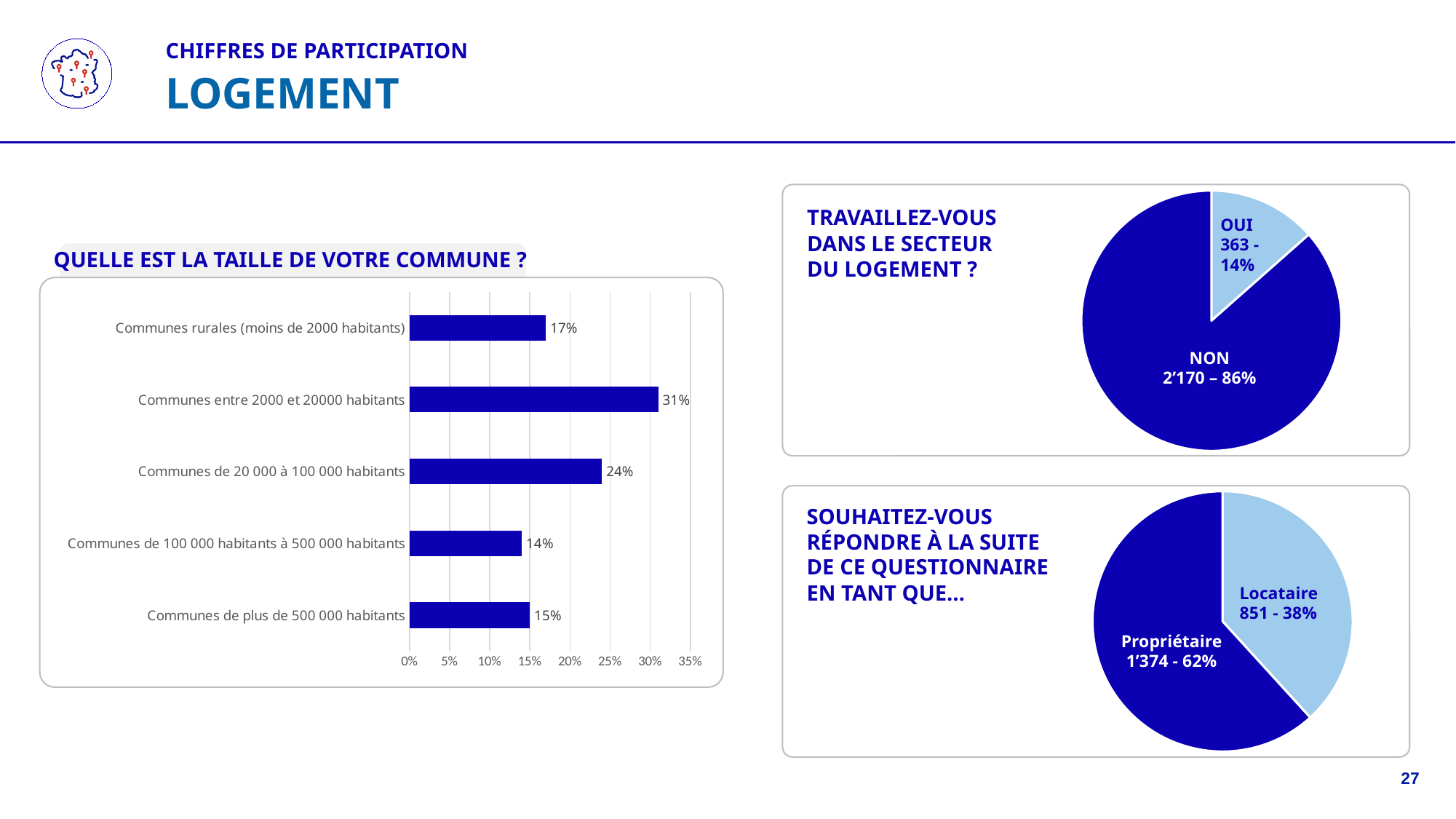
In the pie chart 'TRAVAILLEZ-VOUS DANS LE SECTEUR DU LOGEMENT ?', how many respondents answered 'NON'? 2’170 In the chart 'QUELLE EST LA TAILLE DE VOTRE COMMUNE ?', which is larger: 'Communes rurales (moins de 2000 habitants)' or 'Communes de 20 000 à 100 000 habitants'? Communes de 20 000 à 100 000 habitants In the chart 'QUELLE EST LA TAILLE DE VOTRE COMMUNE ?', what is the difference between 'Communes entre 2000 et 20000 habitants' and 'Communes de 20 000 à 100 000 habitants'? 7% In the chart 'QUELLE EST LA TAILLE DE VOTRE COMMUNE ?', which category has the highest value? Communes entre 2000 et 20000 habitants In the pie chart 'SOUHAITEZ-VOUS RÉPONDRE À LA SUITE DE CE QUESTIONNAIRE EN TANT QUE…', what share of the pie is 'Propriétaire'? 62% In the chart 'QUELLE EST LA TAILLE DE VOTRE COMMUNE ?', what is the value for 'Communes entre 2000 et 20000 habitants'? 31% In the pie chart 'TRAVAILLEZ-VOUS DANS LE SECTEUR DU LOGEMENT ?', what share of the pie is 'OUI'? 14% How many categories are shown in the chart 'QUELLE EST LA TAILLE DE VOTRE COMMUNE ?'? 5 What kind of chart is 'QUELLE EST LA TAILLE DE VOTRE COMMUNE ?'? Bar chart In the chart 'QUELLE EST LA TAILLE DE VOTRE COMMUNE ?', which category has the lowest value? Communes de 100 000 habitants à 500 000 habitants In the pie chart 'SOUHAITEZ-VOUS RÉPONDRE À LA SUITE DE CE QUESTIONNAIRE EN TANT QUE…', how many respondents chose 'Locataire'? 851 In the chart 'QUELLE EST LA TAILLE DE VOTRE COMMUNE ?', what is the value for 'Communes de plus de 500 000 habitants'? 15%